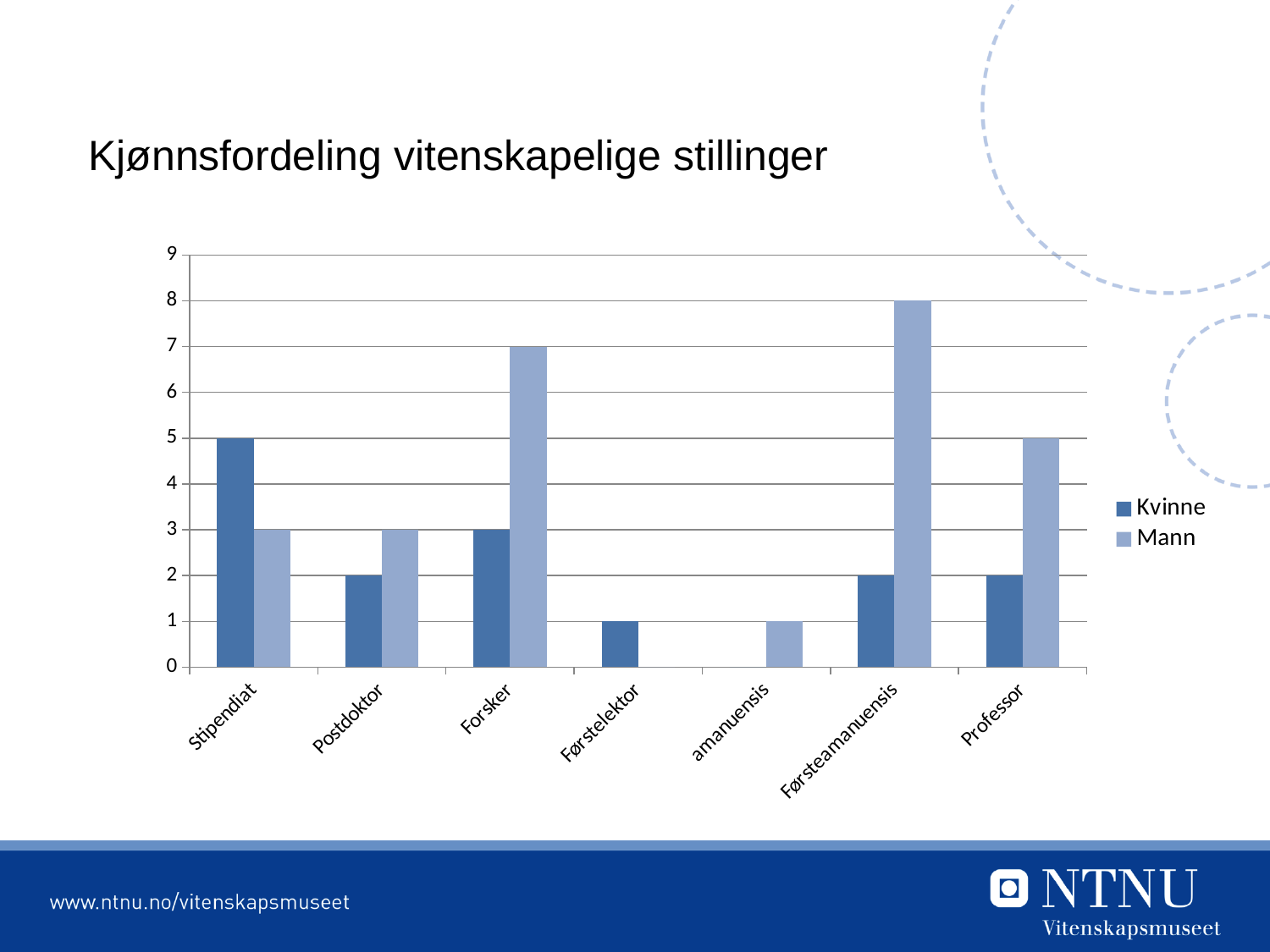
What is the Mann value for Forsker? 7 Which category has the highest Mann value? Førsteamanuensis Is the Mann value for Professor greater or less than 4? greater How many series does the legend list? 2 Which is larger for Postdoktor, the Kvinne value or the Mann value? Mann What is the title of the chart? Kjønnsfordeling vitenskapelige stillinger What is the difference between the Mann and Kvinne values for Førsteamanuensis? 6 What is the Kvinne value for Stipendiat? 5 What is the Mann value for Førsteamanuensis? 8 How many categories are shown on the x axis? 7 Which category has the highest Kvinne value? Stipendiat What kind of chart is shown on the slide? bar chart